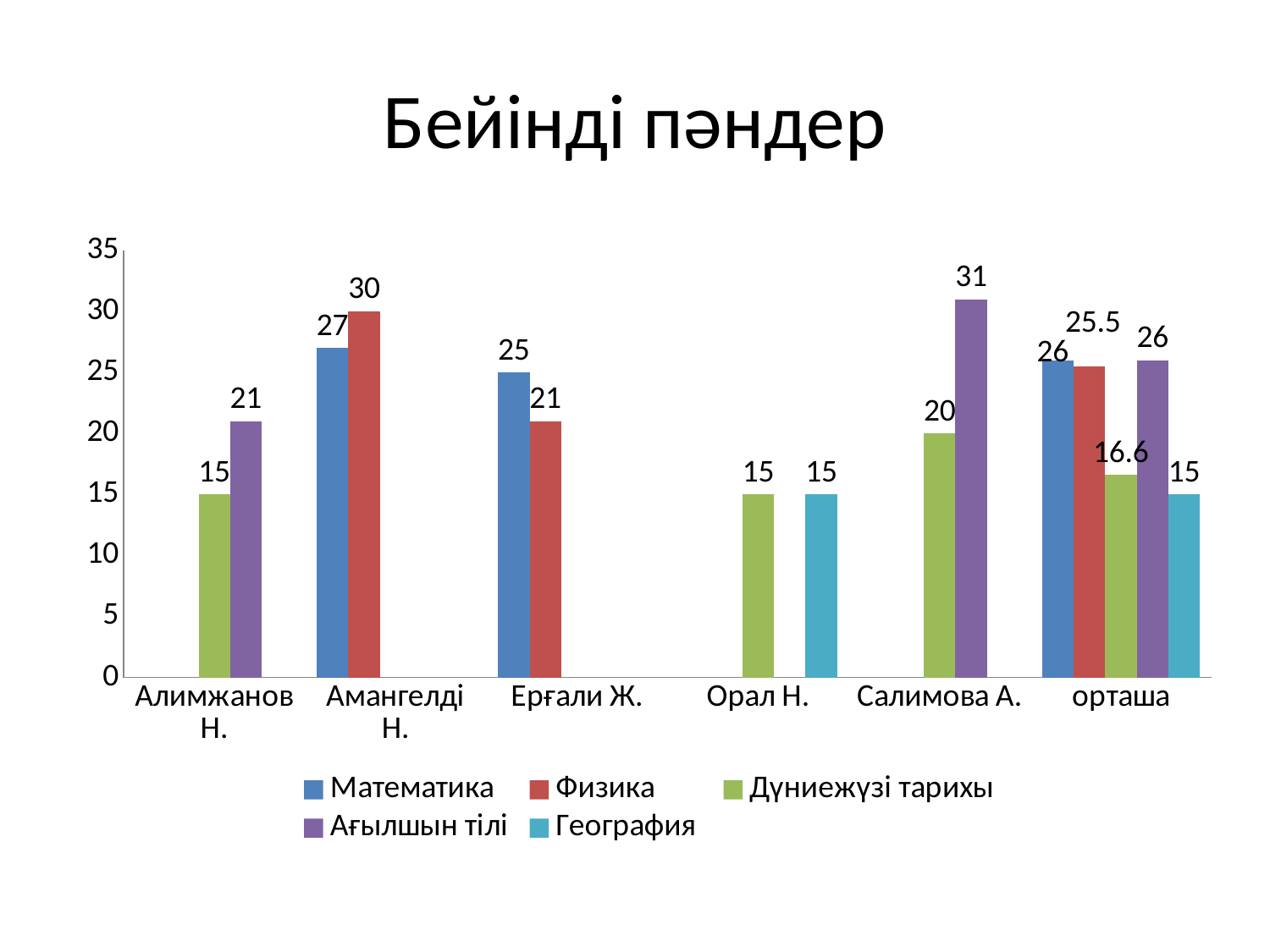
What is the value for Ағылшын тілі for Салимова А.? 31 What is the value for Физика for Амангелді Н.? 30 Which category has the highest Ағылшын тілі value? Салимова А. Which is larger for Ерғали Ж.: Математика or Физика? Математика What is the difference between the Физика and Математика values for Амангелді Н.? 3 What is the value for Математика for Ерғали Ж.? 25 What is the title of the chart? Бейінді пәндер What is the value for Дүниежүзі тарихы for орташа? 16.6 What is the difference between the Ағылшын тілі value for Салимова А. and the Ағылшын тілі value for Алимжанов Н.? 10 How many series does the legend list? 5 What type of chart is shown on the slide? bar chart How many categories are shown on the x axis? 6